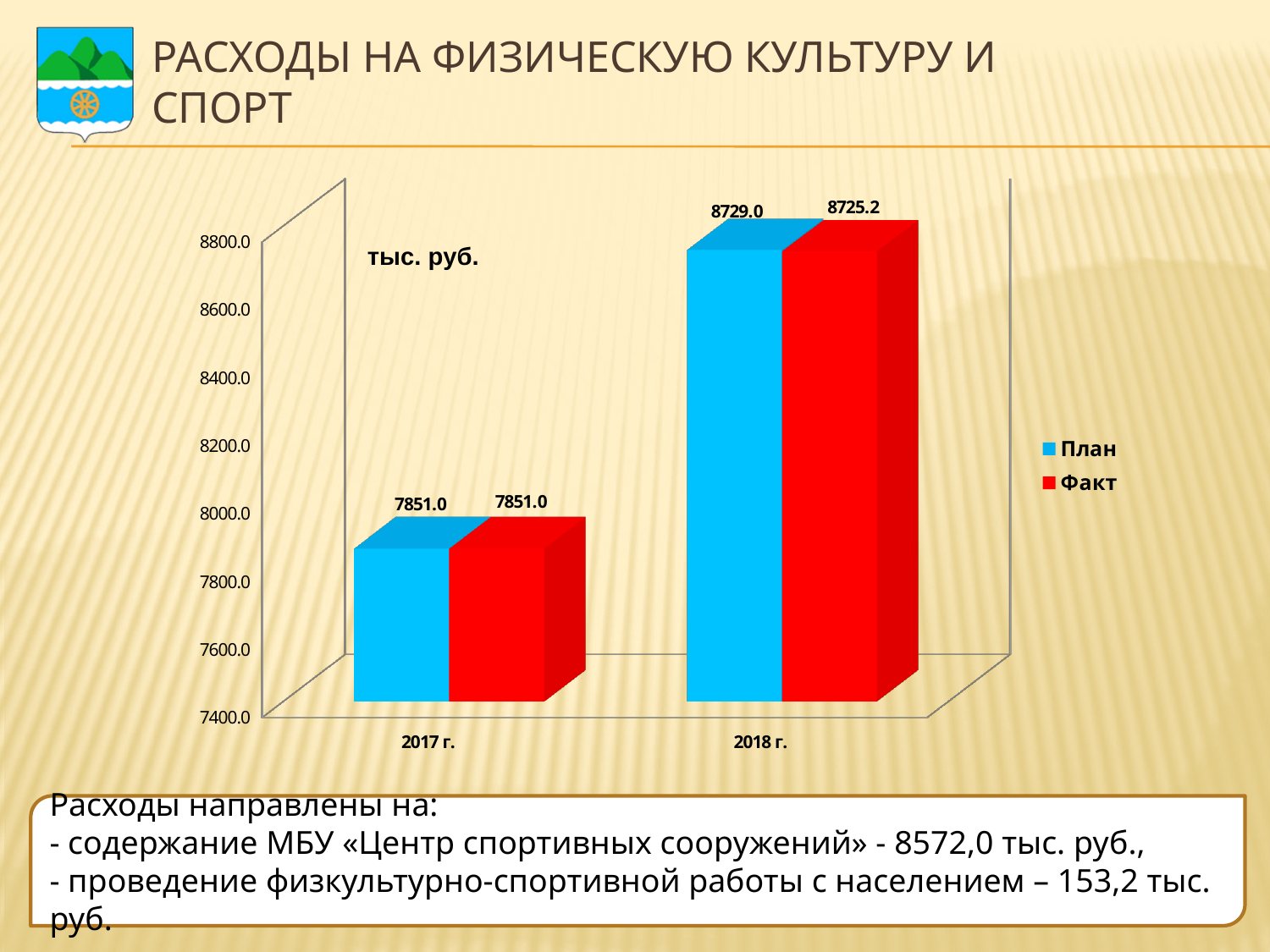
Which year has the lower Факт value? 2017 г. What is the value of Факт for 2018 г.? 8725.2 What is the difference between План and Факт for 2018 г.? 3.8 What is the value of Факт for 2017 г.? 7851.0 Is the Факт value for 2018 г. greater or less than 8600.0? greater What is the value of План for 2017 г.? 7851.0 Which year has the higher План value? 2018 г. What unit label is shown inside the chart area? тыс. руб. What is the difference between the План values for 2018 г. and 2017 г.? 878.0 What is the value of План for 2018 г.? 8729.0 How many series does the legend list? 2 What kind of chart is shown on the slide? bar chart